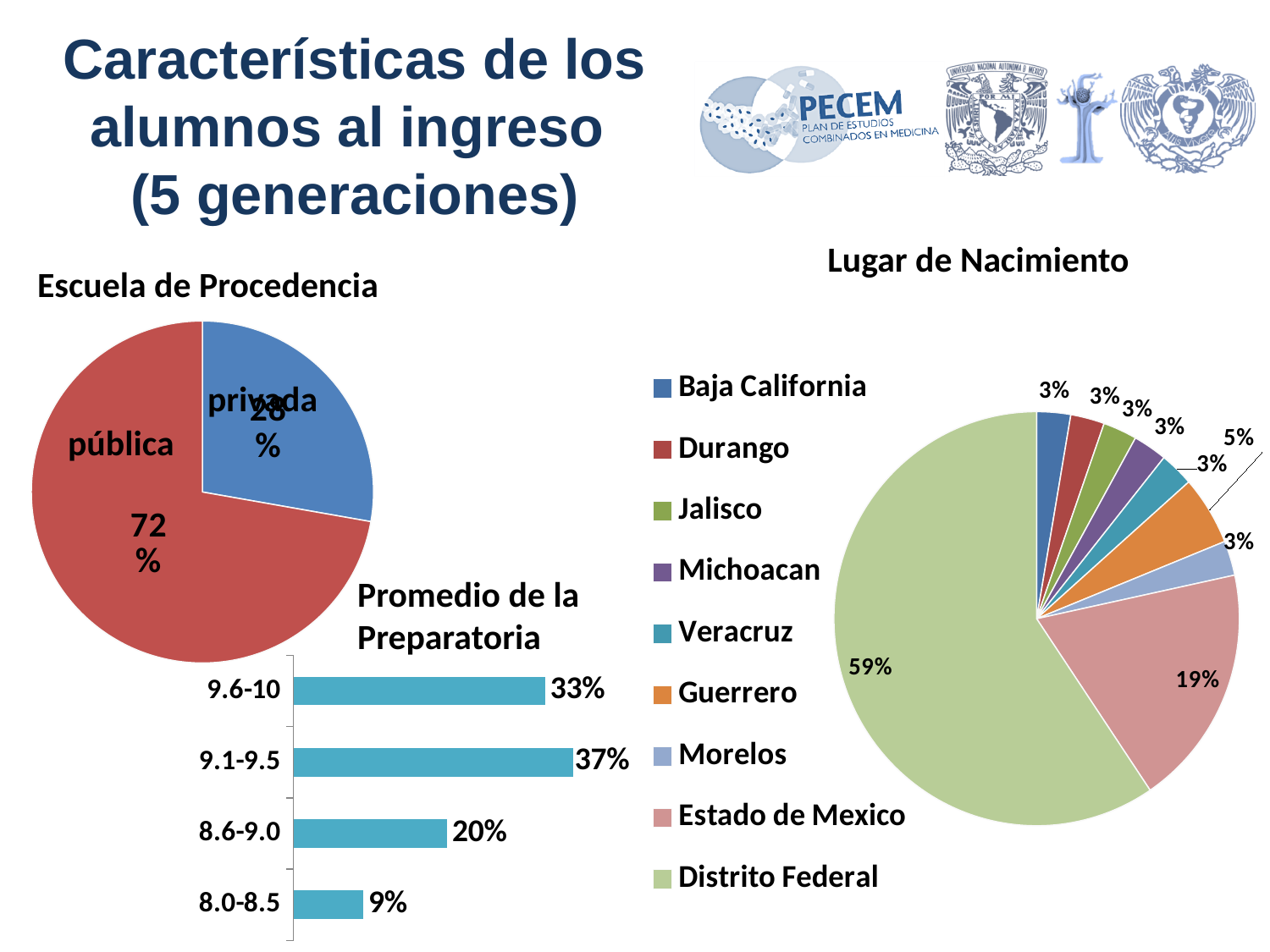
In the 'Lugar de Nacimiento' pie chart, what share corresponds to Estado de Mexico? 19% In the 'Escuela de Procedencia' pie chart, how many slices are there? 2 In the 'Promedio de la Preparatoria' chart, what is the difference between the values for 9.6-10 and 8.6-9.0? 13% What kind of chart is 'Promedio de la Preparatoria'? Bar chart How many categories does the legend of the 'Lugar de Nacimiento' pie chart list? 9 In the 'Promedio de la Preparatoria' chart, which category has the lowest value? 8.0-8.5 In the 'Promedio de la Preparatoria' chart, what is the value for the 9.1-9.5 category? 37% In the 'Promedio de la Preparatoria' chart, what is the value for the 8.0-8.5 category? 9% In the 'Escuela de Procedencia' pie chart, what share of students came from a public school (pública)? 72% In the 'Promedio de la Preparatoria' chart, which category has the highest value? 9.1-9.5 In the 'Escuela de Procedencia' pie chart, what share of students came from a private school (privada)? 28% In the 'Lugar de Nacimiento' pie chart, what share corresponds to Distrito Federal? 59%